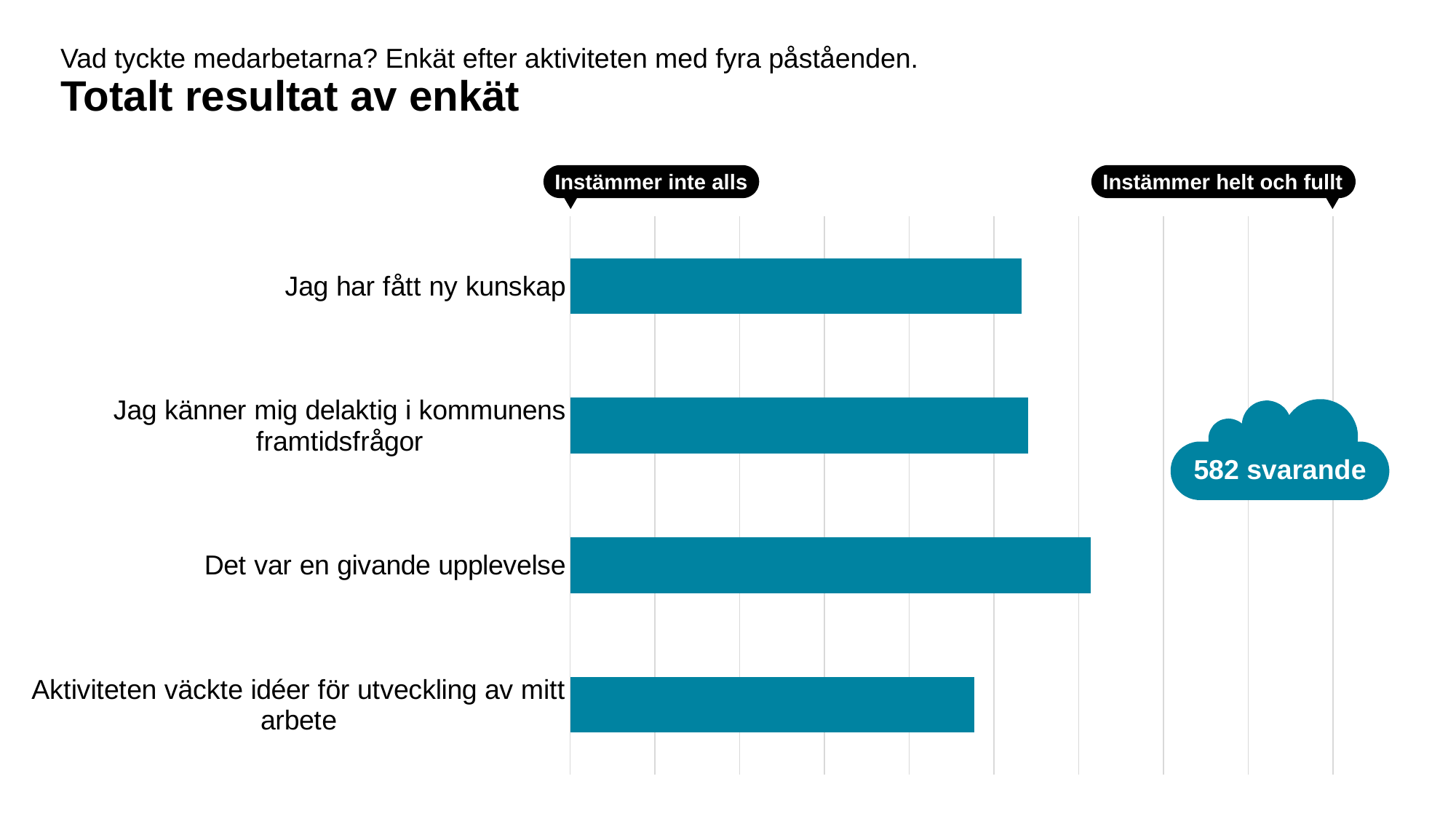
What is the title of the chart on the slide? Totalt resultat av enkät What kind of chart is shown on the slide? Bar chart Which statement has the highest level of agreement (longest bar)? Det var en givande upplevelse Which has the longer bar: "Det var en givande upplevelse" or "Jag har fått ny kunskap"? Det var en givande upplevelse Which has the longer bar: "Jag har fått ny kunskap" or "Aktiviteten väckte idéer för utveckling av mitt arbete"? Jag har fått ny kunskap Which has the longer bar: "Det var en givande upplevelse" or "Aktiviteten väckte idéer för utveckling av mitt arbete"? Det var en givande upplevelse How many statements (categories) are plotted in the chart? 4 Which statement has the lowest level of agreement (shortest bar)? Aktiviteten väckte idéer för utveckling av mitt arbete How many respondents does the slide say answered the survey? 582 svarande